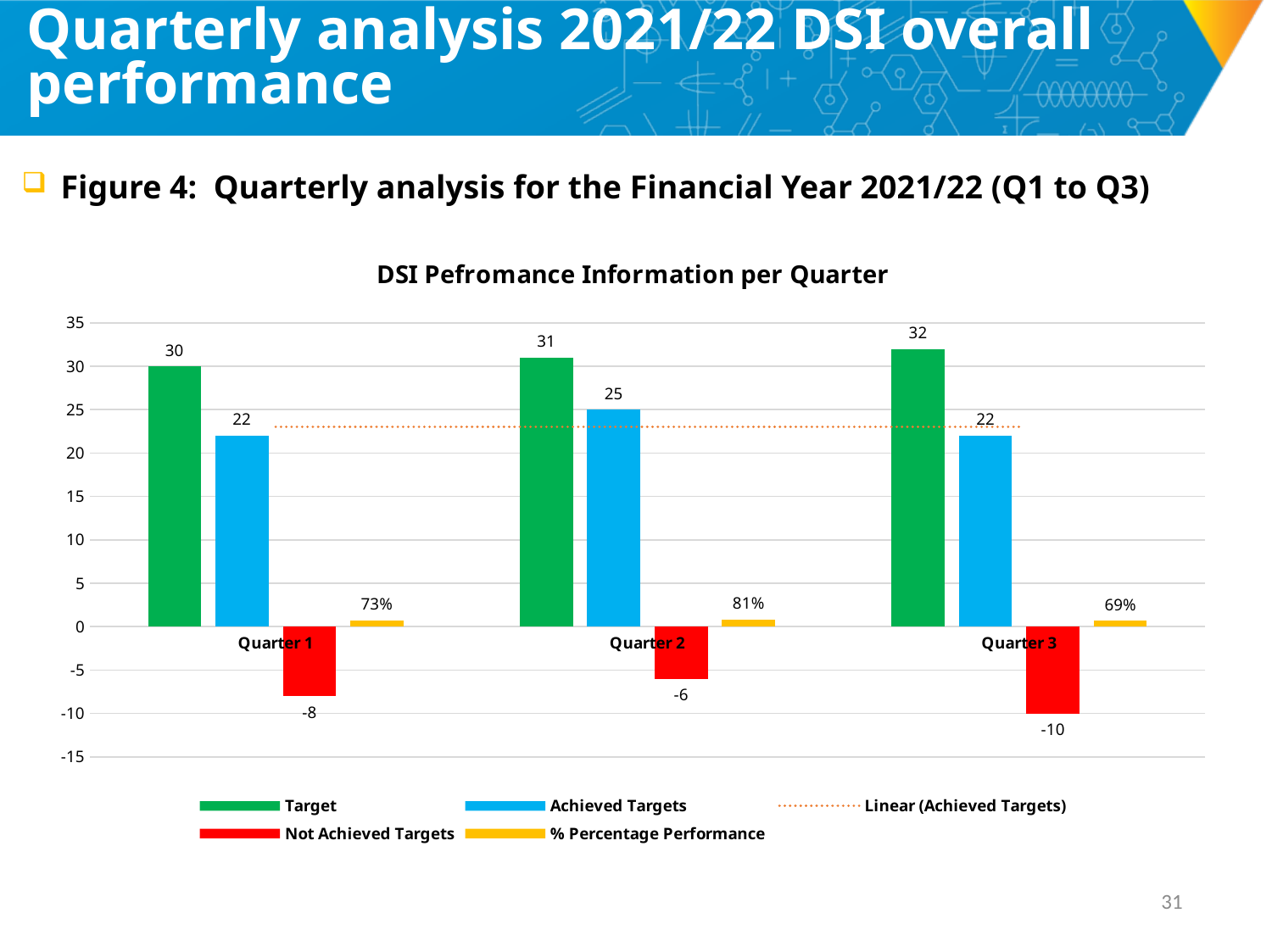
Which quarter has the lowest % Percentage Performance? Quarter 3 Is the Achieved Targets value larger in Quarter 2 or Quarter 1? Quarter 2 What kind of chart is this? Bar chart What is the % Percentage Performance for Quarter 2? 81% How many quarters are shown on the x axis? 3 What is the Achieved Targets value for Quarter 3? 22 What is the title of the chart? DSI Pefromance Information per Quarter What is the Target value for Quarter 2? 31 Which quarter has the highest Target value? Quarter 3 How many entries does the legend list? 5 What is the difference between the Target and Achieved Targets values in Quarter 3? 10 What is the Not Achieved Targets value for Quarter 1? -8